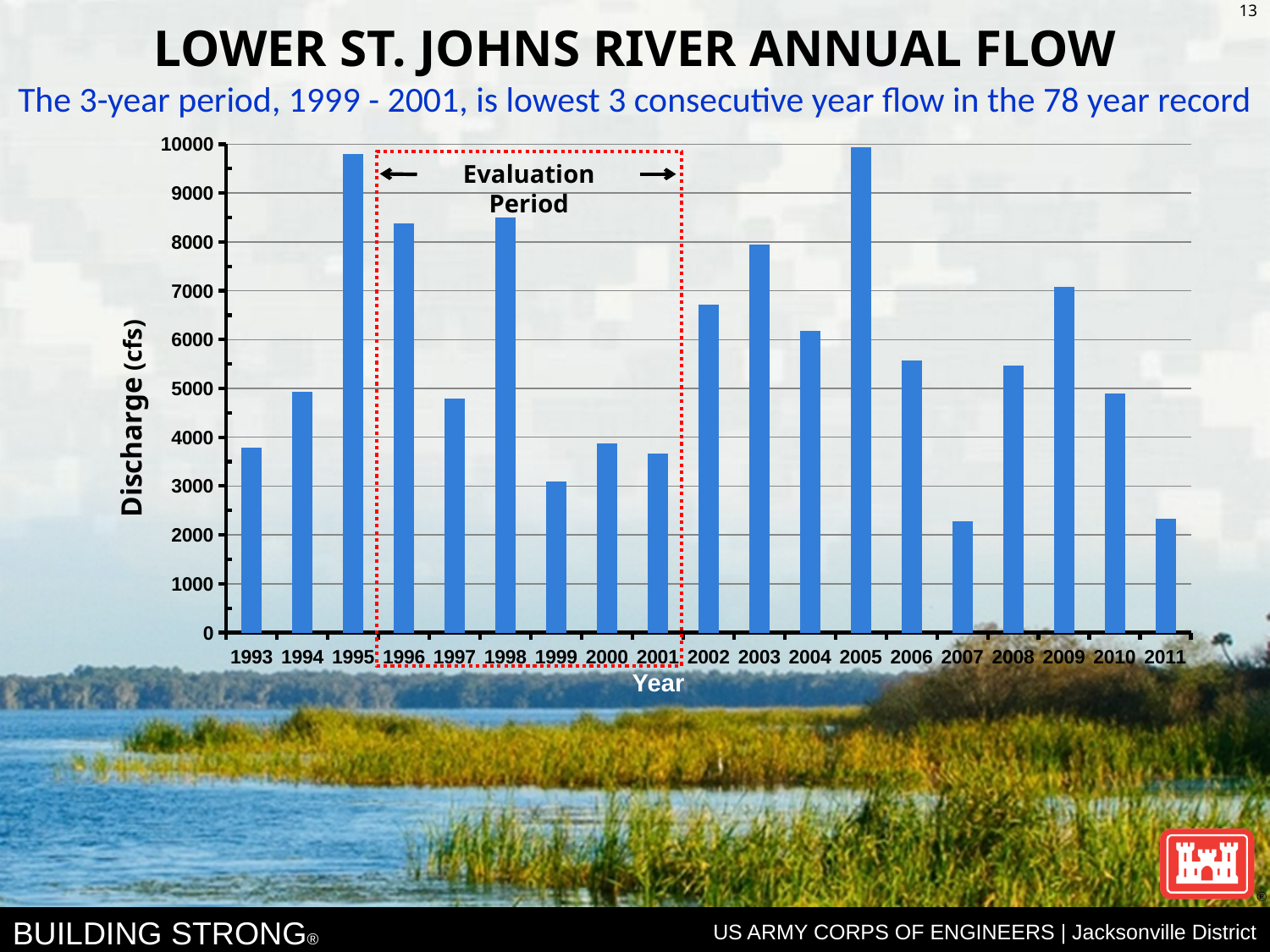
Is the discharge value for 2002 greater or less than 6000? greater What is the label of the y axis of the chart? Discharge (cfs) Which years does the dashed red box labelled 'Evaluation Period' enclose? 1996 to 2001 Is the discharge value for 2006 greater or less than 5000? greater Is the discharge value for 1995 greater or less than 9000? greater How many years are plotted on the x axis of the chart? 19 Which year has the larger discharge, 2002 or 2004? 2002 Which year has the larger discharge, 1996 or 1997? 1996 What kind of chart is shown on the slide? bar chart